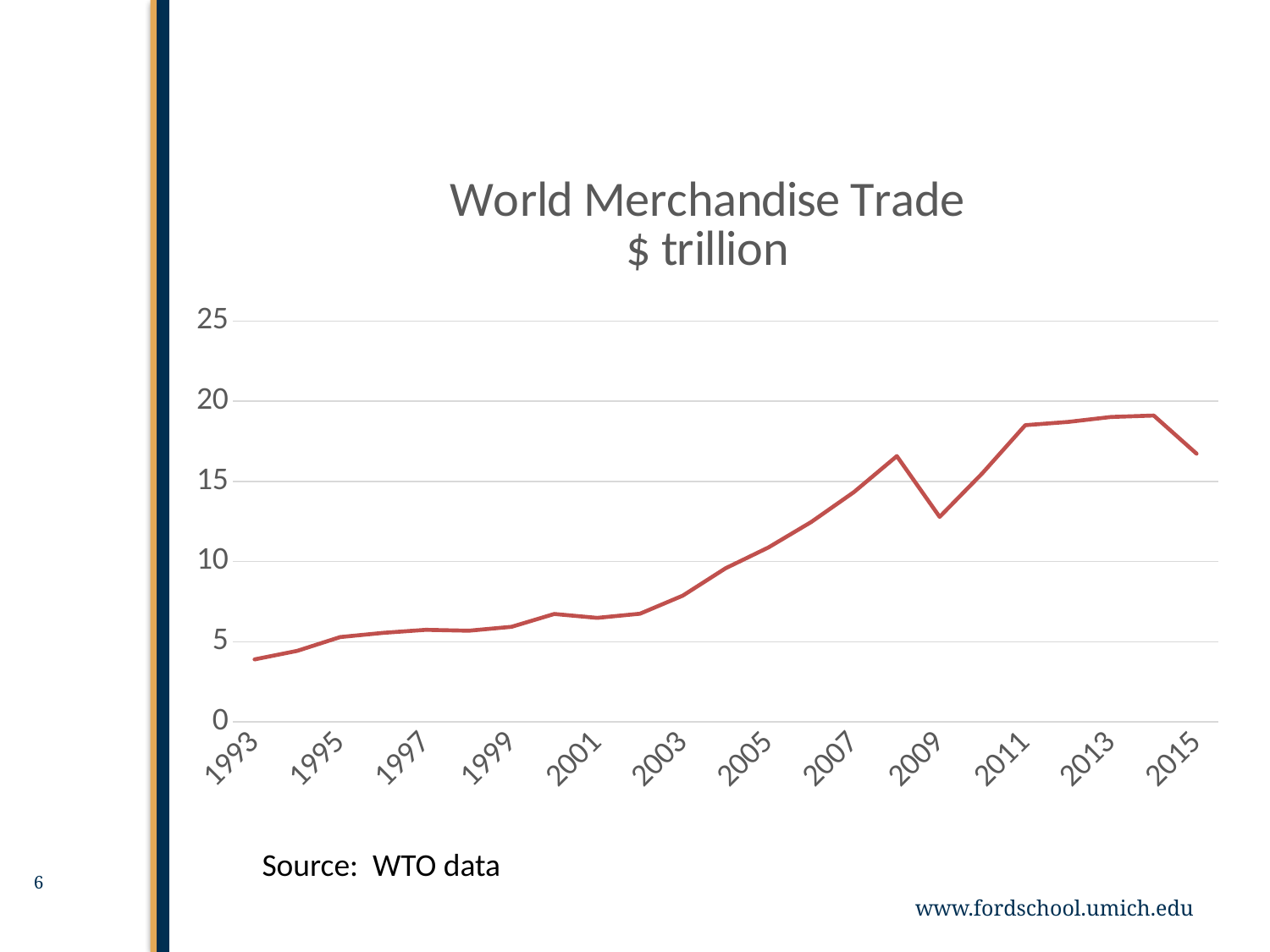
Is the value for 2009 greater or less than 10? greater What is the title of the chart? World Merchandise Trade $ trillion What kind of chart is shown on the slide? line chart Is the value for 2003 greater or less than 10? less Which year has the lowest value of world merchandise trade on the chart? 1993 Is the value for 2011 greater or less than 20? less Which year has the larger value, 2009 or 2011? 2011 Does world merchandise trade generally rise or fall from 1993 to 2015? rise What is the source of the data cited below the chart? WTO data How many year labels are shown on the x axis? 12